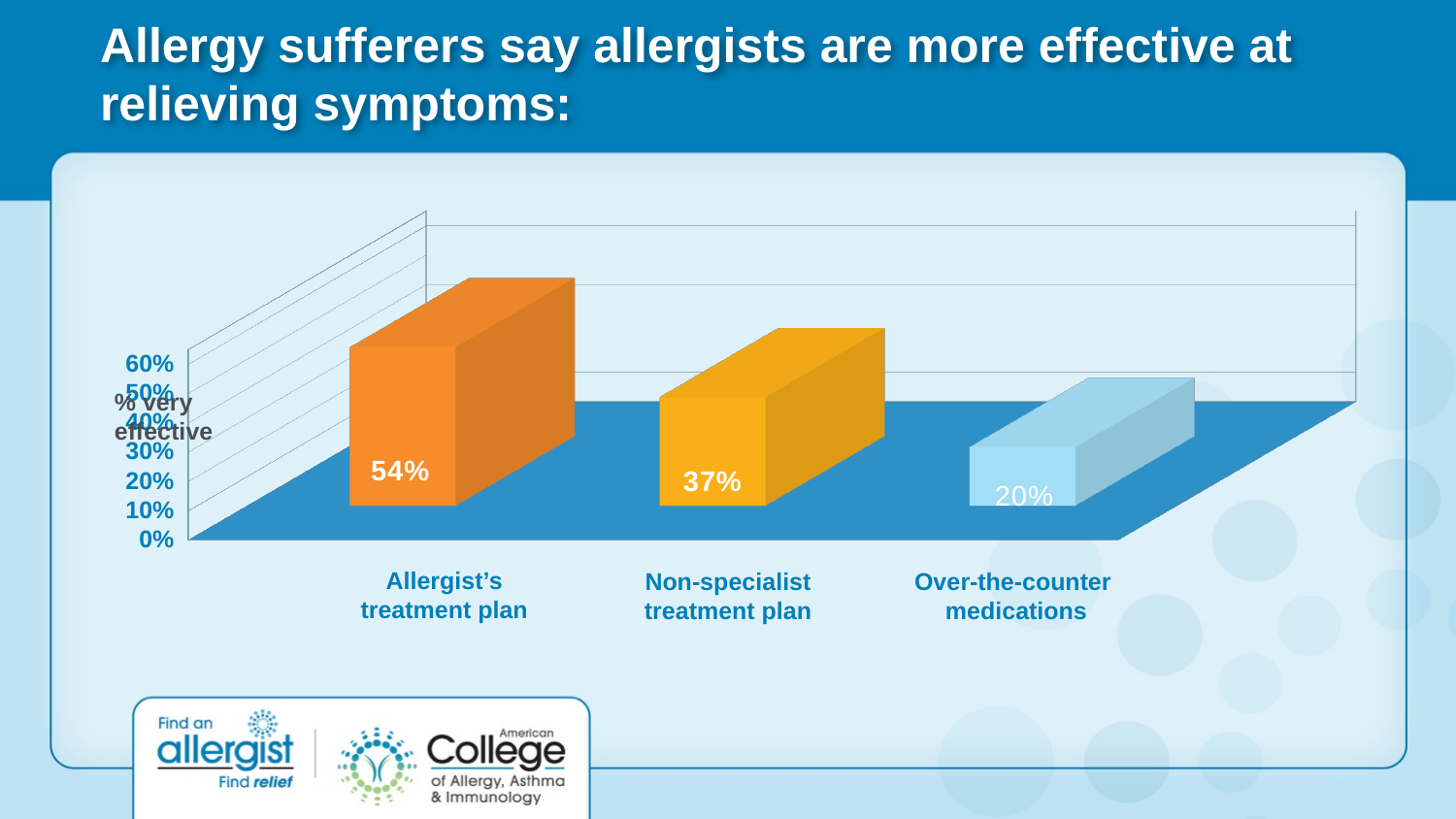
What kind of chart is shown on the slide? Bar chart What is the value for Non-specialist treatment plan? 37% What is the value for Allergist's treatment plan? 54% Do the values rise or fall from left to right across the categories? Fall Which category has the highest value? Allergist's treatment plan What is the value for Over-the-counter medications? 20% What is the difference between the values for Allergist's treatment plan and Non-specialist treatment plan? 17% Which is larger, the value for Non-specialist treatment plan or Over-the-counter medications? Non-specialist treatment plan How many categories are shown in the chart? 3 Is the value for Allergist's treatment plan greater or less than 50%? greater What is the difference between the values for Non-specialist treatment plan and Over-the-counter medications? 17% Which category has the lowest value? Over-the-counter medications